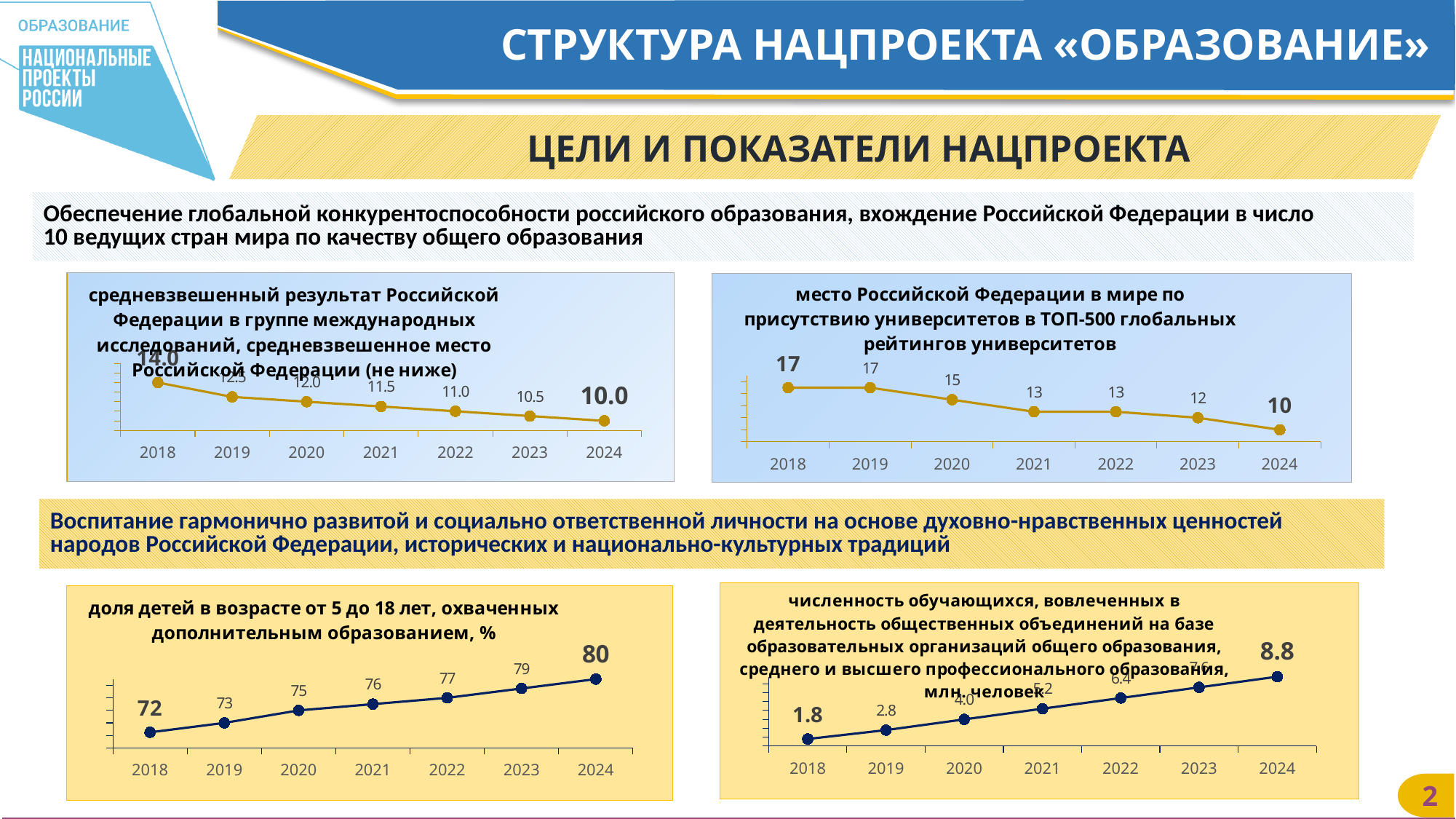
In the bottom-right chart (численность обучающихся, вовлеченных в деятельность общественных объединений, млн. человек), which is larger, the value for 2019 or the value for 2024? 2024 In the top-right chart (место Российской Федерации в мире по присутствию университетов в ТОП-500), what is the difference between the 2018 and 2024 values? 7 In the bottom-left chart (доля детей, охваченных дополнительным образованием, %), what is the difference between the 2024 and 2018 values? 8 In the top-left chart (средневзвешенное место Российской Федерации), what is the value for 2018? 14.0 What type of chart is the bottom-right chart (численность обучающихся, млн. человек)? line chart In the top-right chart (место Российской Федерации в мире по присутствию университетов в ТОП-500), what is the value for 2020? 15 In the top-left chart (средневзвешенное место Российской Федерации), do the values rise or fall from 2018 to 2024? fall In the top-right chart (место Российской Федерации в мире по присутствию университетов в ТОП-500), how many years are plotted? 7 In the top-left chart (средневзвешенное место Российской Федерации), what is the value for 2024? 10.0 In the bottom-right chart (численность обучающихся, вовлеченных в деятельность общественных объединений, млн. человек), what is the value for 2018? 1.8 In the bottom-left chart (доля детей, охваченных дополнительным образованием, %), which year has the highest value? 2024 In the bottom-left chart (доля детей, охваченных дополнительным образованием, %), what is the value for 2021? 76